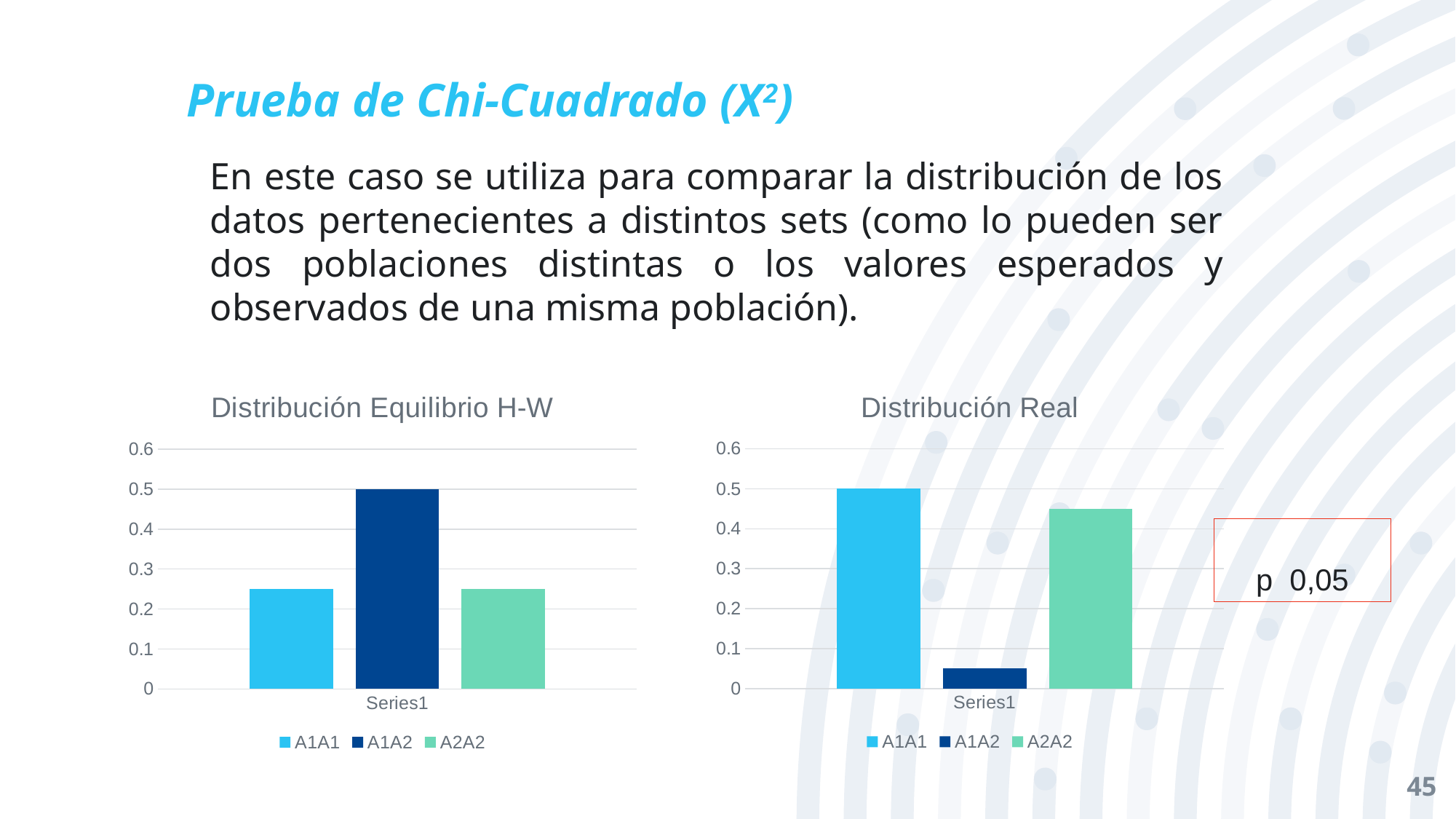
What is the title of the chart on the right side of the slide? Distribución Real How many series does the legend of the 'Distribución Real' chart list? 3 In the 'Distribución Real' chart, which series has the lowest value? A1A2 In the 'Distribución Real' chart, is the value for A2A2 greater or less than 0.4? greater In the 'Distribución Real' chart, what is the value for A1A1? 0.5 In the 'Distribución Equilibrio H-W' chart, is the value for A1A1 greater or less than 0.3? less In the 'Distribución Equilibrio H-W' chart, is the value for A2A2 greater or less than 0.2? greater In the 'Distribución Equilibrio H-W' chart, what is the value for A1A2? 0.5 In the 'Distribución Equilibrio H-W' chart, which series has the highest value? A1A2 In the 'Distribución Real' chart, which is larger, the value for A1A1 or the value for A1A2? A1A1 What kind of chart is the 'Distribución Equilibrio H-W' chart? bar chart